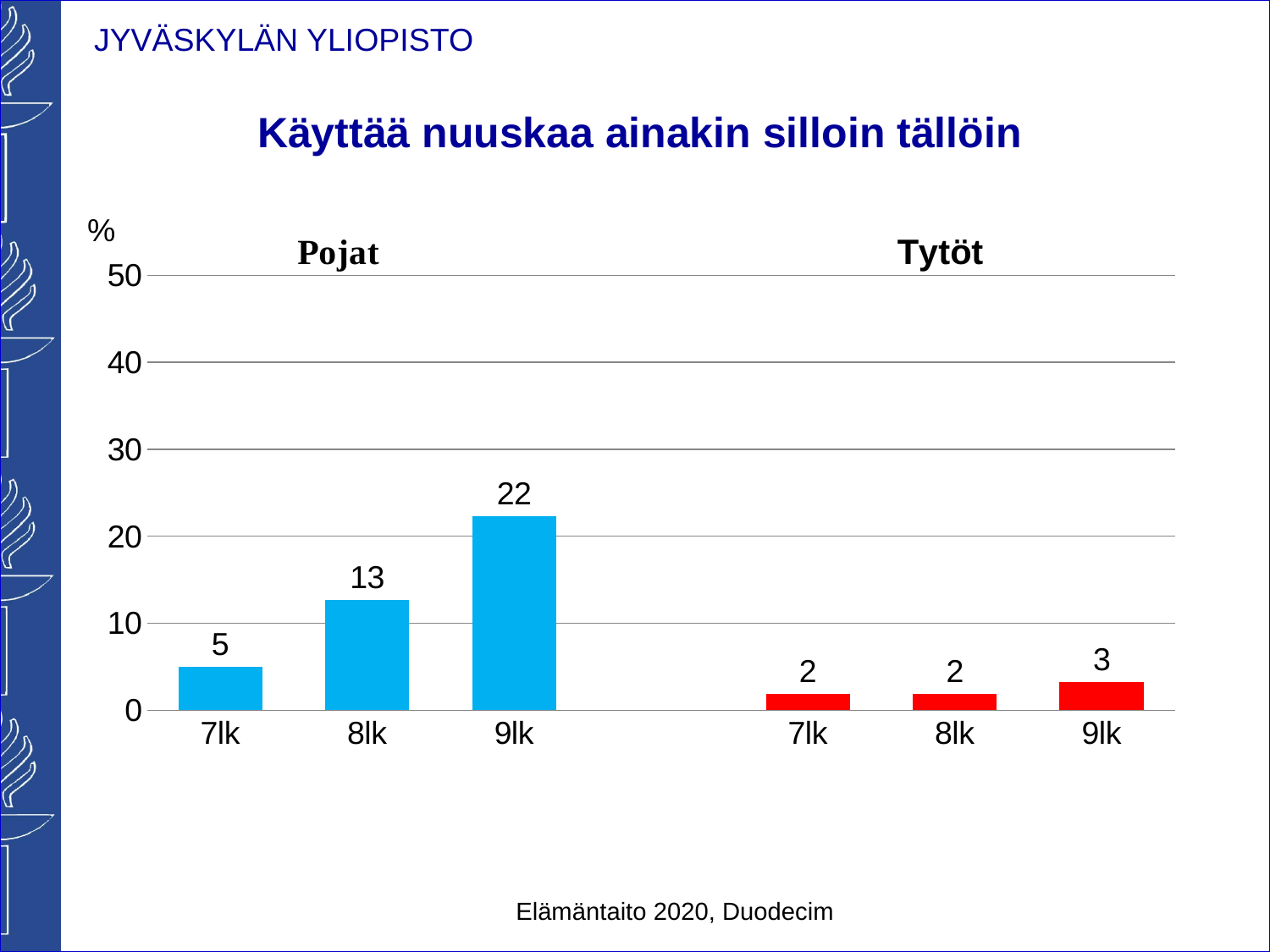
What is the value for 8lk in the Pojat group? 13 What is the value for 7lk in the Tytöt group? 2 Do the values in the Pojat group rise or fall from 7lk to 9lk? rise Which bar has the highest value on the chart? Pojat 9lk What is the value for 9lk in the Pojat group? 22 How many bars are plotted on the chart in total? 6 What kind of chart is shown on the slide? bar chart Is the value for Pojat 9lk greater or less than 20? greater Which is larger, the Pojat 8lk value or the Tytöt 9lk value? Pojat 8lk Which grade has the highest value in the Tytöt group? 9lk What is the difference between the Pojat 9lk value and the Pojat 7lk value? 17 What is the difference between the Pojat 9lk value and the Tytöt 9lk value? 19